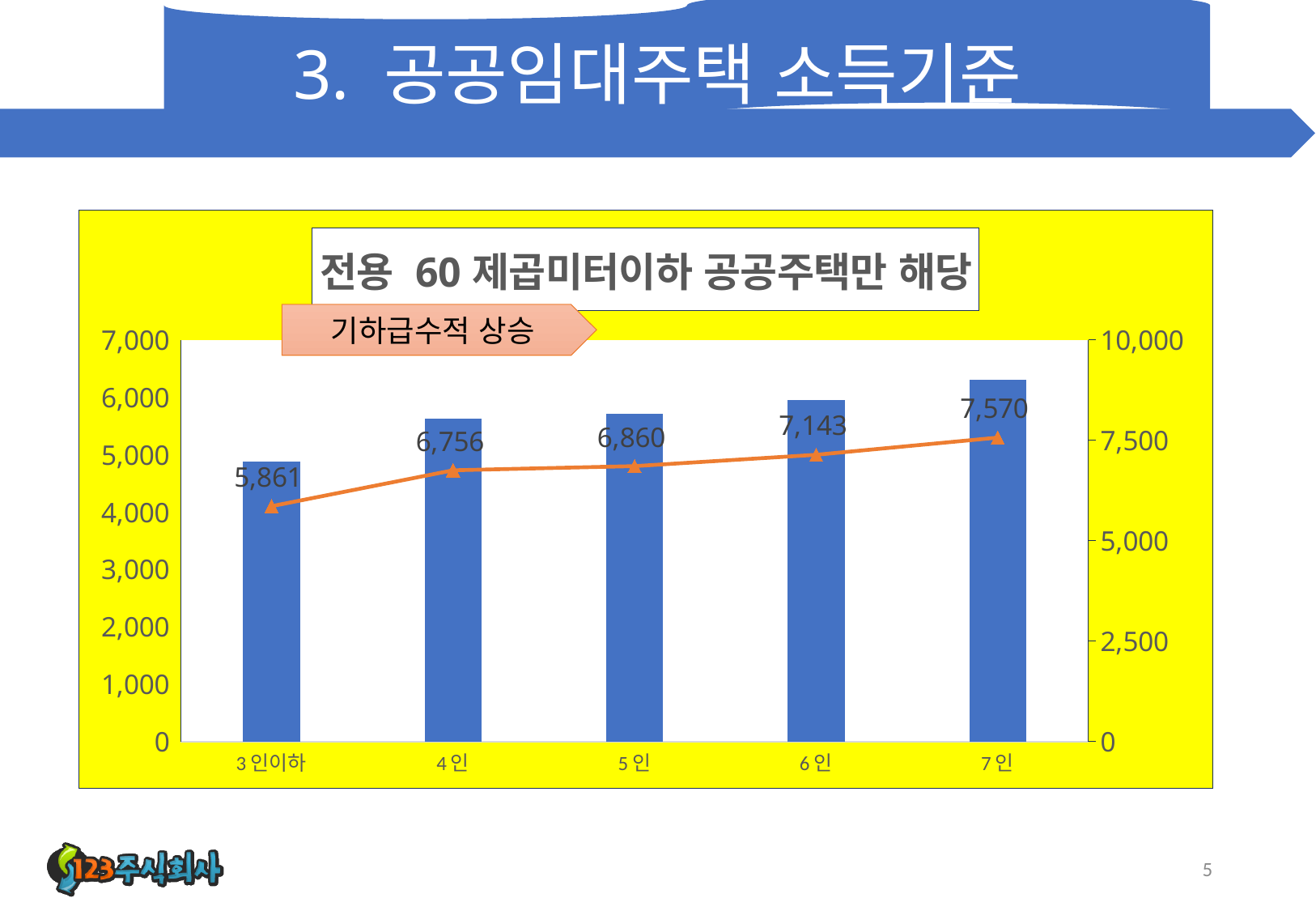
What is the value shown on the line for 6인? 7,143 Do the line values rise or fall from 3인이하 to 7인? rise Is the bar for 7인 greater or less than 6,000 on the left axis? greater What is the difference between the line values for 6인 and 5인? 283 What is the value shown on the line for 4인? 6,756 Which has the larger line value, 4인 or 6인? 6인 What is the difference between the line values for 7인 and 3인이하? 1,709 Which category has the highest value on the line? 7인 What is the value shown on the line for 3인이하? 5,861 How many categories are shown on the x axis? 5 Which category has the lowest value on the line? 3인이하 What is the title of the chart? 전용 60 제곱미터이하 공공주택만 해당